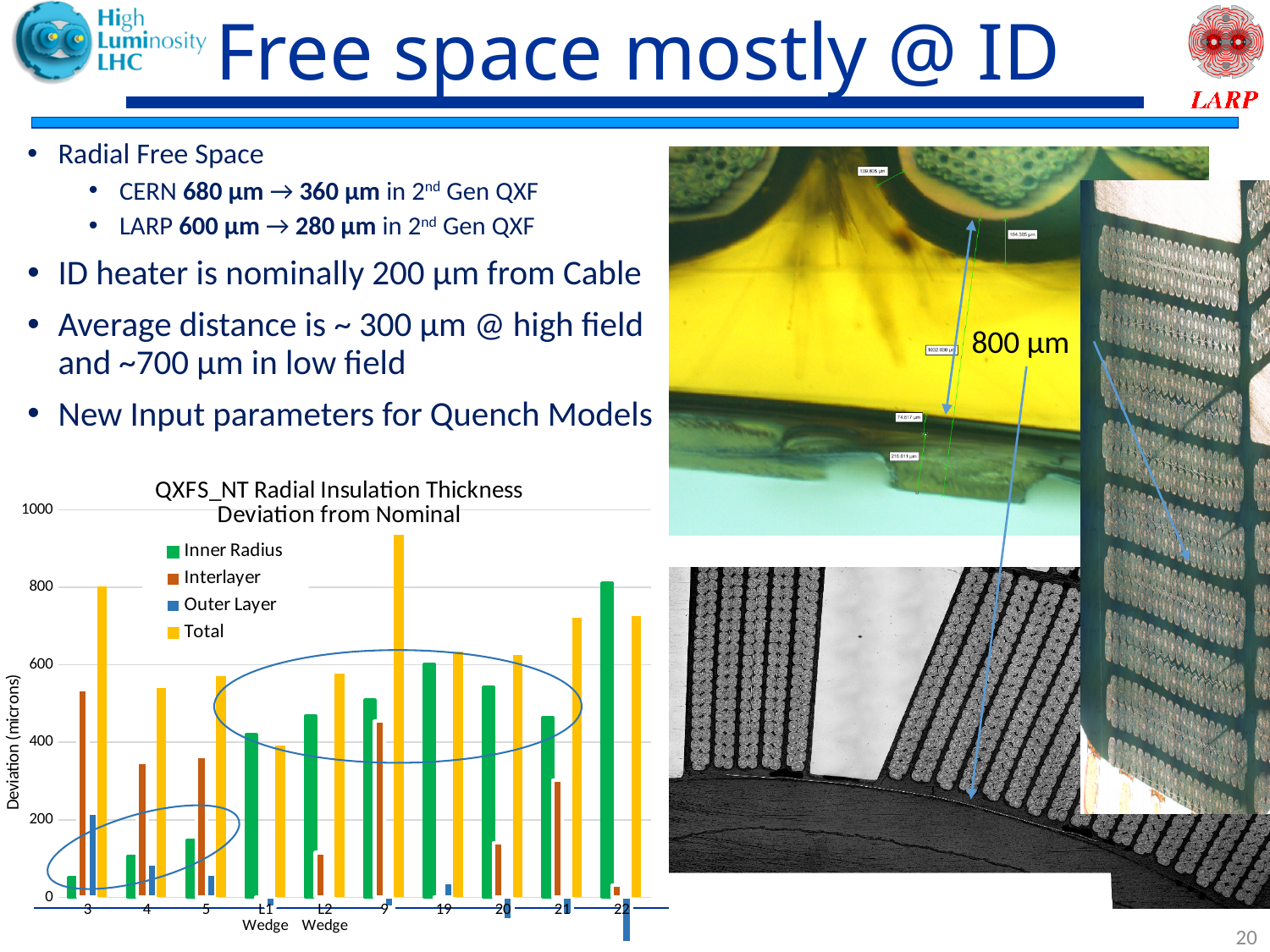
What is the title of the chart? QXFS_NT Radial Insulation Thickness Deviation from Nominal What kind of chart is shown on the slide? bar chart How many series does the legend of the chart list? 4 Which category has the highest Total value? 9 Is the Total value for category 9 greater or less than 800? greater Is the Inner Radius value for category 3 greater or less than 200? less Is the Total value for category 21 greater or less than 600? greater Which category has the lowest Total value? L1 Wedge How many categories are shown along the x axis of the chart? 10 What is the label of the y axis of the chart? Deviation (microns) Which is larger, the Inner Radius value for category 22 or the Inner Radius value for category 3? 22